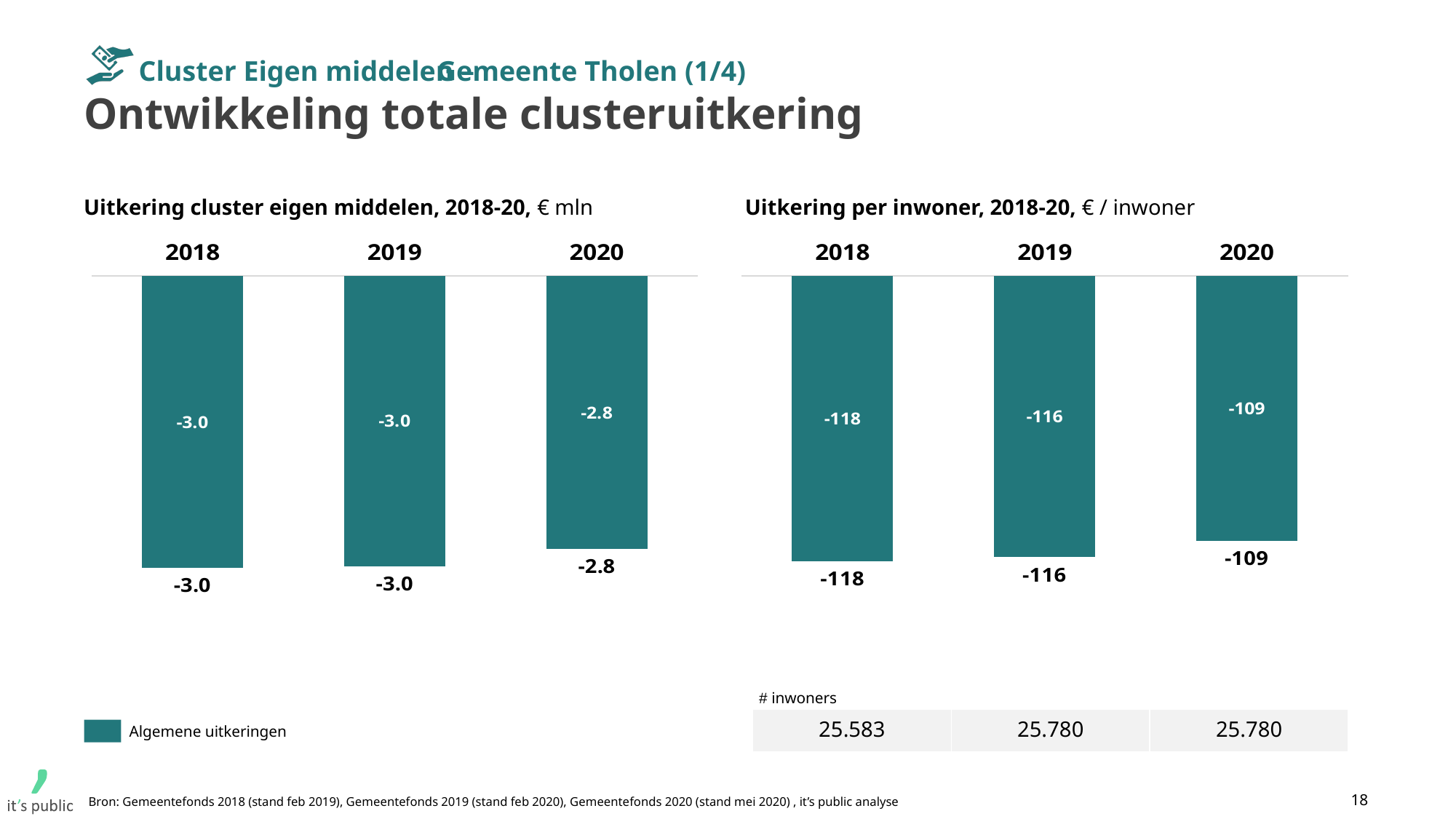
In the chart 'Uitkering cluster eigen middelen, 2018-20', what is the value for 2020? -2.8 What type of chart is 'Uitkering per inwoner, 2018-20'? Bar chart In the chart 'Uitkering per inwoner, 2018-20', what is the value for 2019? -116 In the chart 'Uitkering per inwoner, 2018-20', what is the difference between the 2018 and 2020 values? 9 What series name does the legend below the left chart show? Algemene uitkeringen In the chart 'Uitkering per inwoner, 2018-20', is the value for 2018 or 2020 more negative? 2018 In the chart 'Uitkering per inwoner, 2018-20', what is the value for 2020? -109 In the chart 'Uitkering cluster eigen middelen, 2018-20', what is the difference between the 2019 and 2020 values? 0.2 In the chart 'Uitkering per inwoner, 2018-20', do the values become less negative or more negative from 2018 to 2020? Less negative In the chart 'Uitkering cluster eigen middelen, 2018-20', what is the value for 2018? -3.0 In the chart 'Uitkering per inwoner, 2018-20', which year has the lowest (most negative) value? 2018 How many years are shown in the chart 'Uitkering cluster eigen middelen, 2018-20'? 3